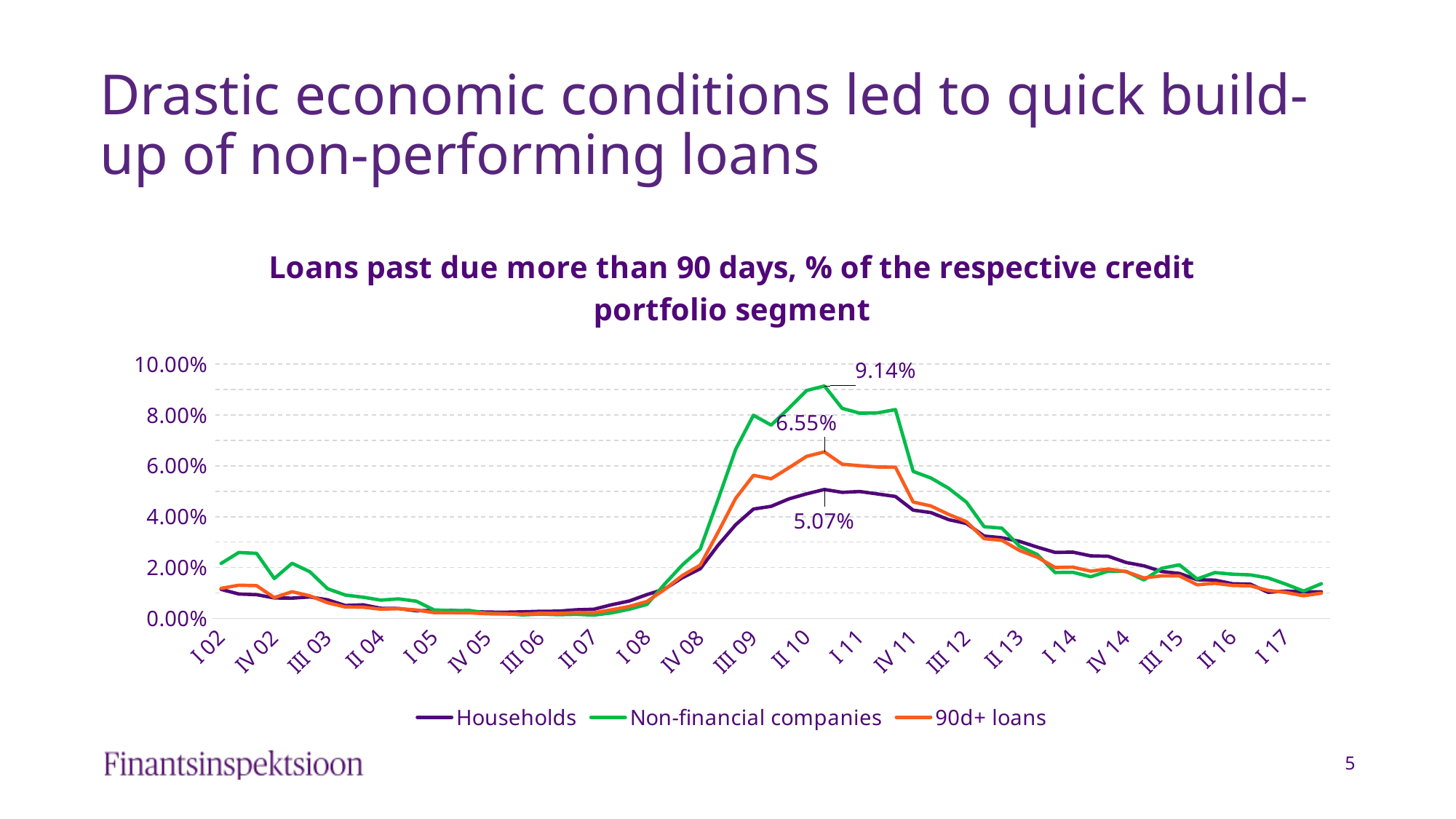
Does the Non-financial companies series rise or fall between I 11 and I 17? fall Is the value for Non-financial companies at III 09 greater or less than 6.00%? greater Is the value for Households at I 02 greater or less than 2.00%? less Which series reaches the highest labelled peak value? Non-financial companies How many series does the legend list? 3 What kind of chart is shown on the slide? line chart What is the peak value labelled for the Non-financial companies series? 9.14% What is the peak value labelled for the Households series? 5.07% Which series has the lowest labelled peak value? Households What is the difference between the labelled peak of Non-financial companies (9.14%) and the labelled peak of 90d+ loans (6.55%)? 2.59 percentage points What is the difference between the labelled peak of Non-financial companies (9.14%) and the labelled peak of Households (5.07%)? 4.07 percentage points What is the peak value labelled for the 90d+ loans series? 6.55%